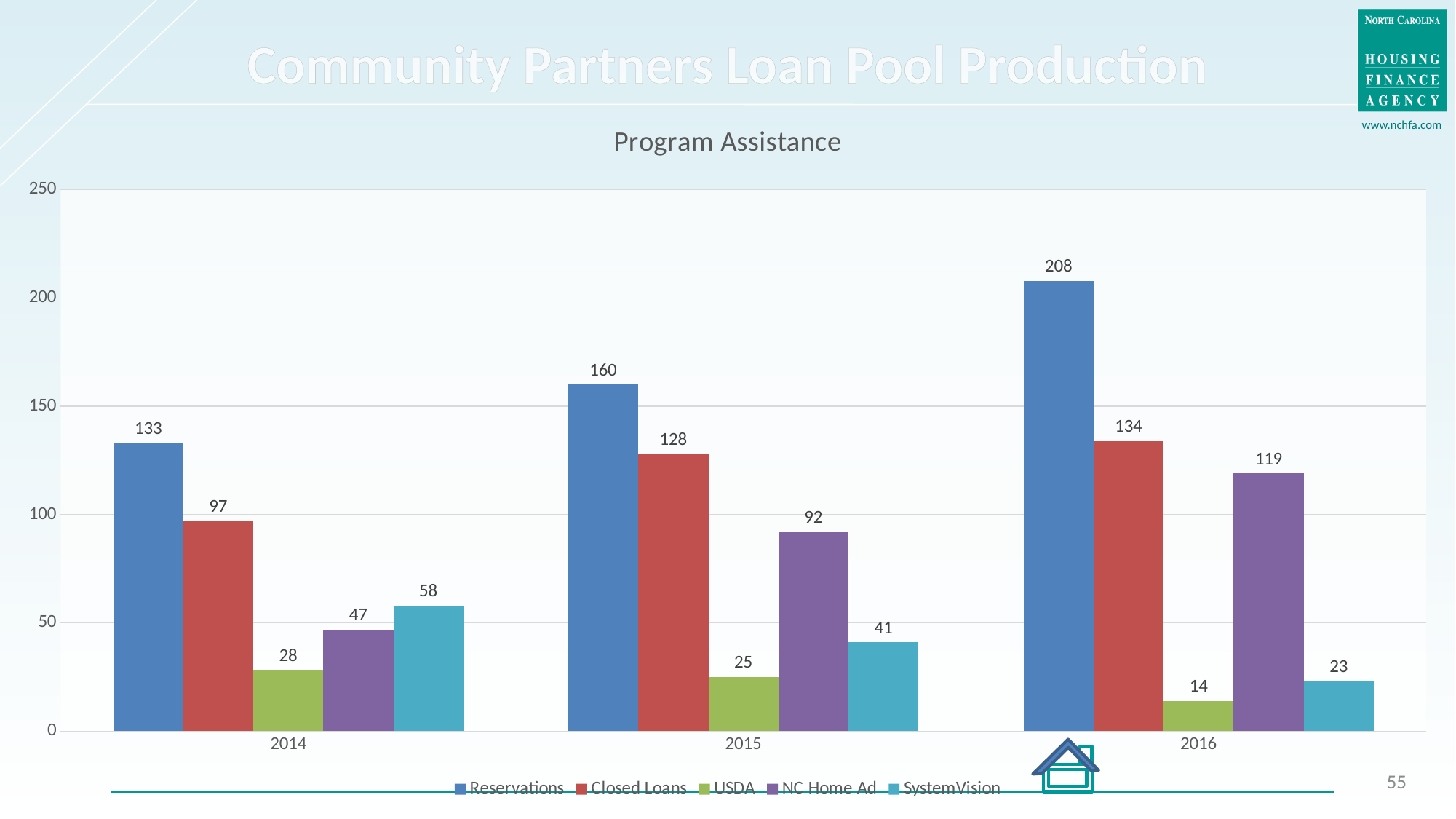
What kind of chart is shown? bar chart Which year has the lowest value for USDA? 2016 Which is larger in 2014: NC Home Ad or SystemVision? SystemVision What is the value for SystemVision in 2014? 58 How many years are shown on the x axis? 3 Is the value for NC Home Ad in 2016 greater or less than 100? greater What is the value for USDA in 2015? 25 What is the difference between Reservations and Closed Loans in 2015? 32 Which year has the highest value for Closed Loans? 2016 Do the Reservations values rise or fall from 2014 to 2016? rise What is the value for Reservations in 2016? 208 How many series does the legend list? 5